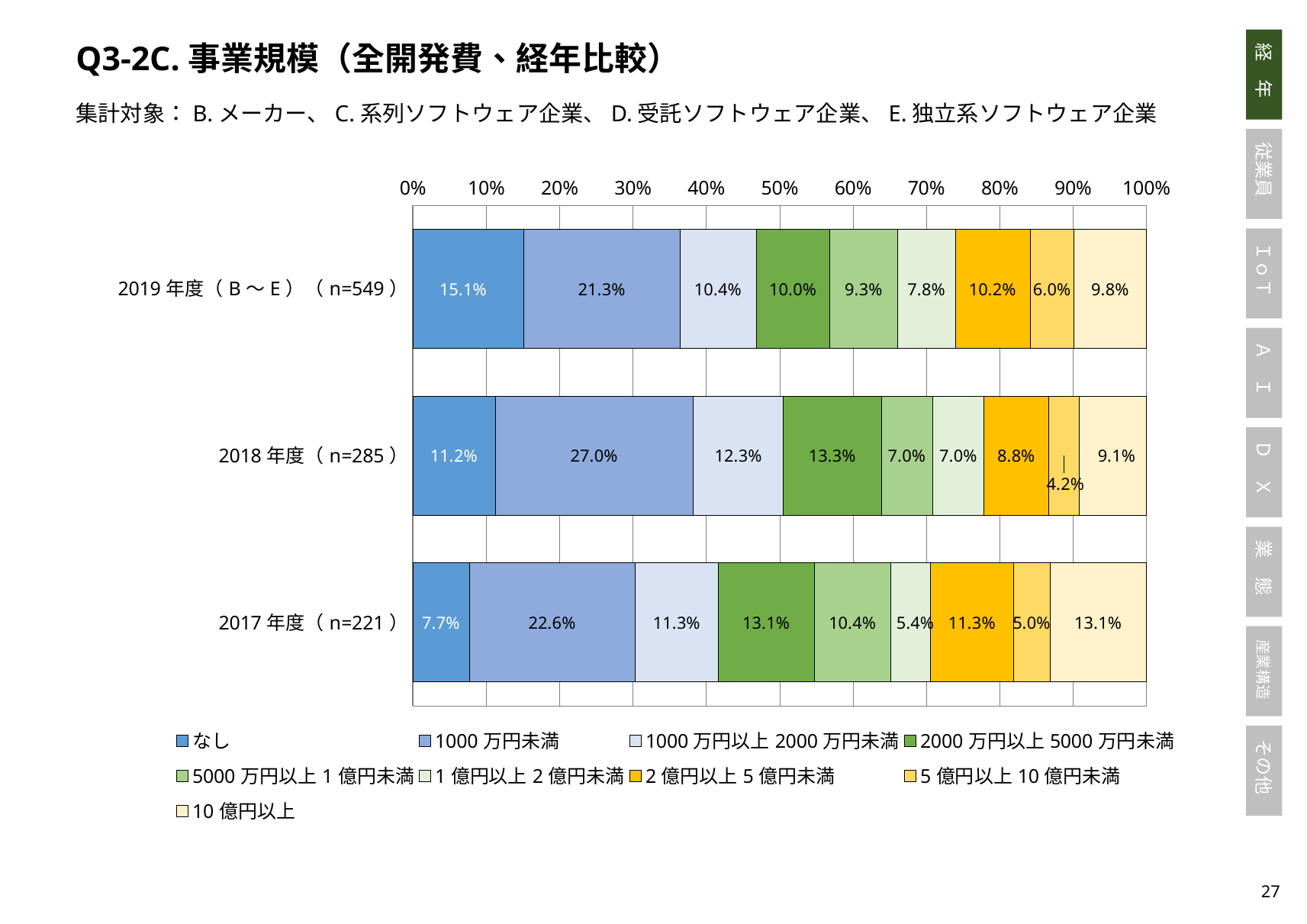
Which year has the lowest value for 1000 万円未満? 2019 年度 (B～E) (n=549) How many years (bars) are shown in the chart? 3 What is the value for 5 億円以上 10 億円未満 in 2018 年度 (n=285)? 4.2% What is the value for 1000 万円未満 in 2018 年度 (n=285)? 27.0% What is the value for 10 億円以上 in 2017 年度 (n=221)? 13.1% What kind of chart is shown on the slide? Stacked bar chart What is the difference between the 1000 万円未満 values for 2018 年度 and 2017 年度? 4.4% Which year has the highest value for なし? 2019 年度 (B～E) (n=549) Which is larger: the 2000 万円以上 5000 万円未満 value for 2018 年度 or for 2019 年度? 2018 年度 How many series does the legend list? 9 Which legend entry is shown in the darkest blue colour? なし What is the value for なし in 2019 年度 (B～E) (n=549)? 15.1%